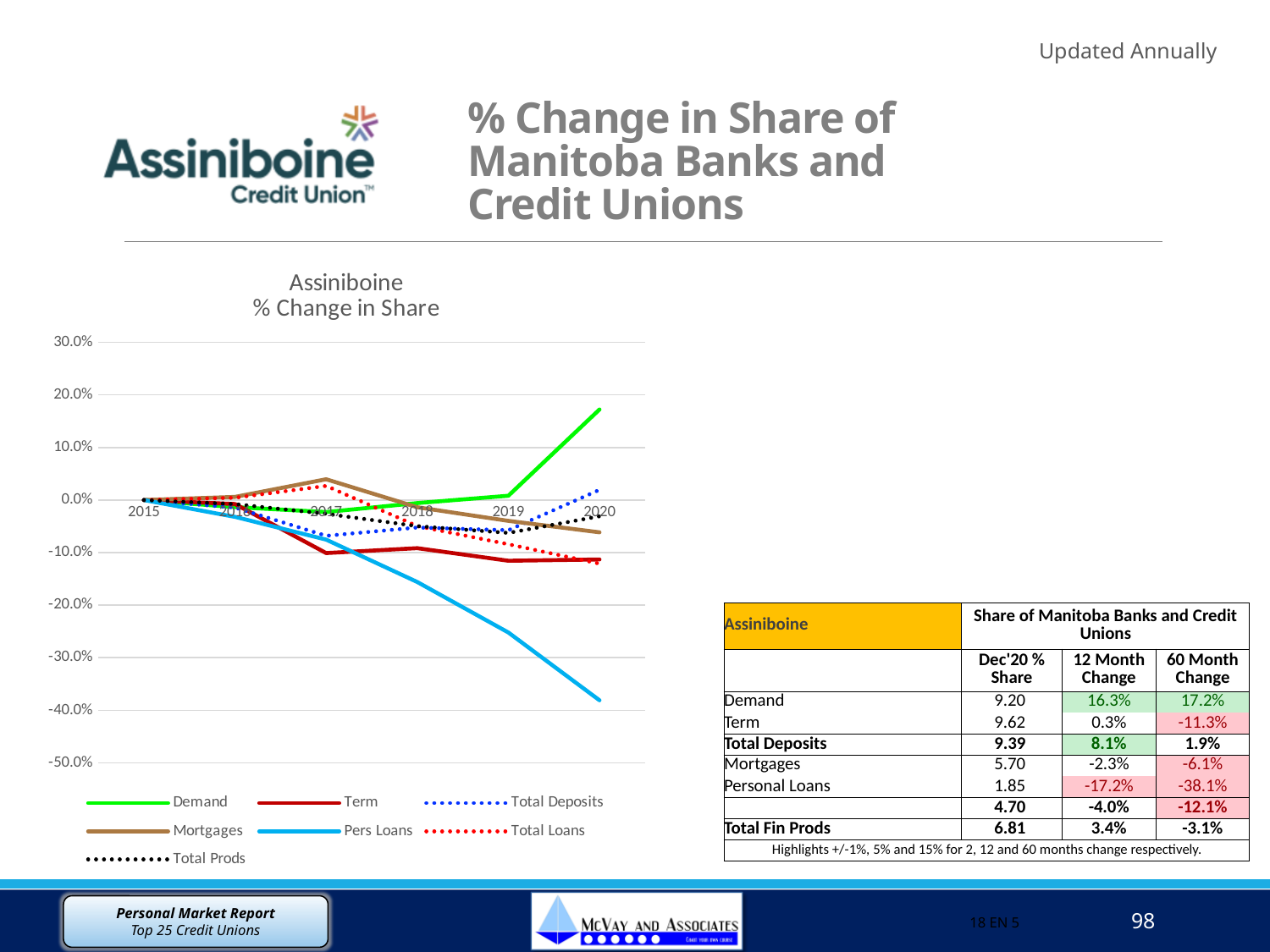
In the "Assiniboine % Change in Share" chart, is the value for Demand in 2020 greater or less than 10.0%? greater In the "Assiniboine % Change in Share" chart, is the value for Pers Loans in 2020 greater or less than -30.0%? less In the "Assiniboine % Change in Share" chart, which is larger in 2017: Mortgages or Term? Mortgages In the "Assiniboine % Change in Share" chart, which series has the highest value in 2020? Demand How many series does the legend of the "Assiniboine % Change in Share" chart list? 7 How many years are plotted along the x axis of the "Assiniboine % Change in Share" chart? 6 In the "Assiniboine % Change in Share" chart, is the value for Pers Loans in 2019 greater or less than -20.0%? less What kind of chart is the "Assiniboine % Change in Share" chart? line chart What is the title of the line chart on the slide? Assiniboine % Change in Share In the "Assiniboine % Change in Share" chart, which series has the lowest value in 2020? Pers Loans In the "Assiniboine % Change in Share" chart, which is larger in 2020: Demand or Pers Loans? Demand In the "Assiniboine % Change in Share" chart, does the Pers Loans series rise or fall from 2015 to 2020? fall